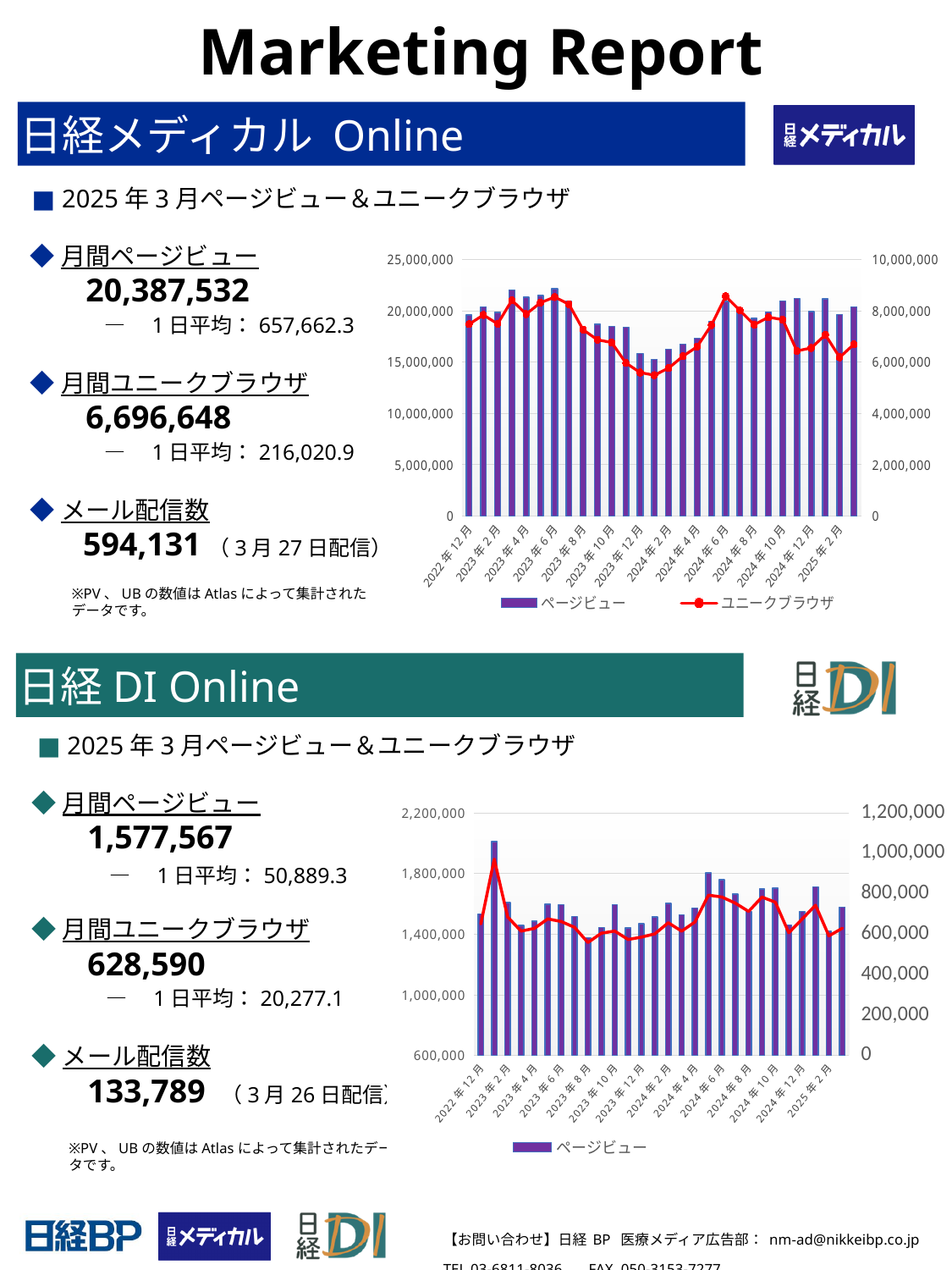
On the 日経メディカル Online chart, how many series does the legend list? 2 On the 日経メディカル Online chart, is the ページビュー value for 2023年6月 greater or less than 20,000,000? greater On the 日経メディカル Online chart, do ページビュー values rise or fall from 2023年6月 to 2023年12月? fall On the 日経 DI Online chart, which month has the highest ページビュー bar? 2023年1月 On the 日経メディカル Online chart, what kind of chart is used to show ページビュー and ユニークブラウザ? Bar and line chart On the 日経メディカル Online chart, is the ページビュー value for 2023年12月 greater or less than 20,000,000? less On the 日経 DI Online chart, is the ページビュー value for 2023年8月 greater or less than 1,800,000? less On the 日経メディカル Online chart, what colour is the ユニークブラウザ line? Red On the 日経メディカル Online chart, which has the higher ページビュー value, 2023年6月 or 2023年12月? 2023年6月